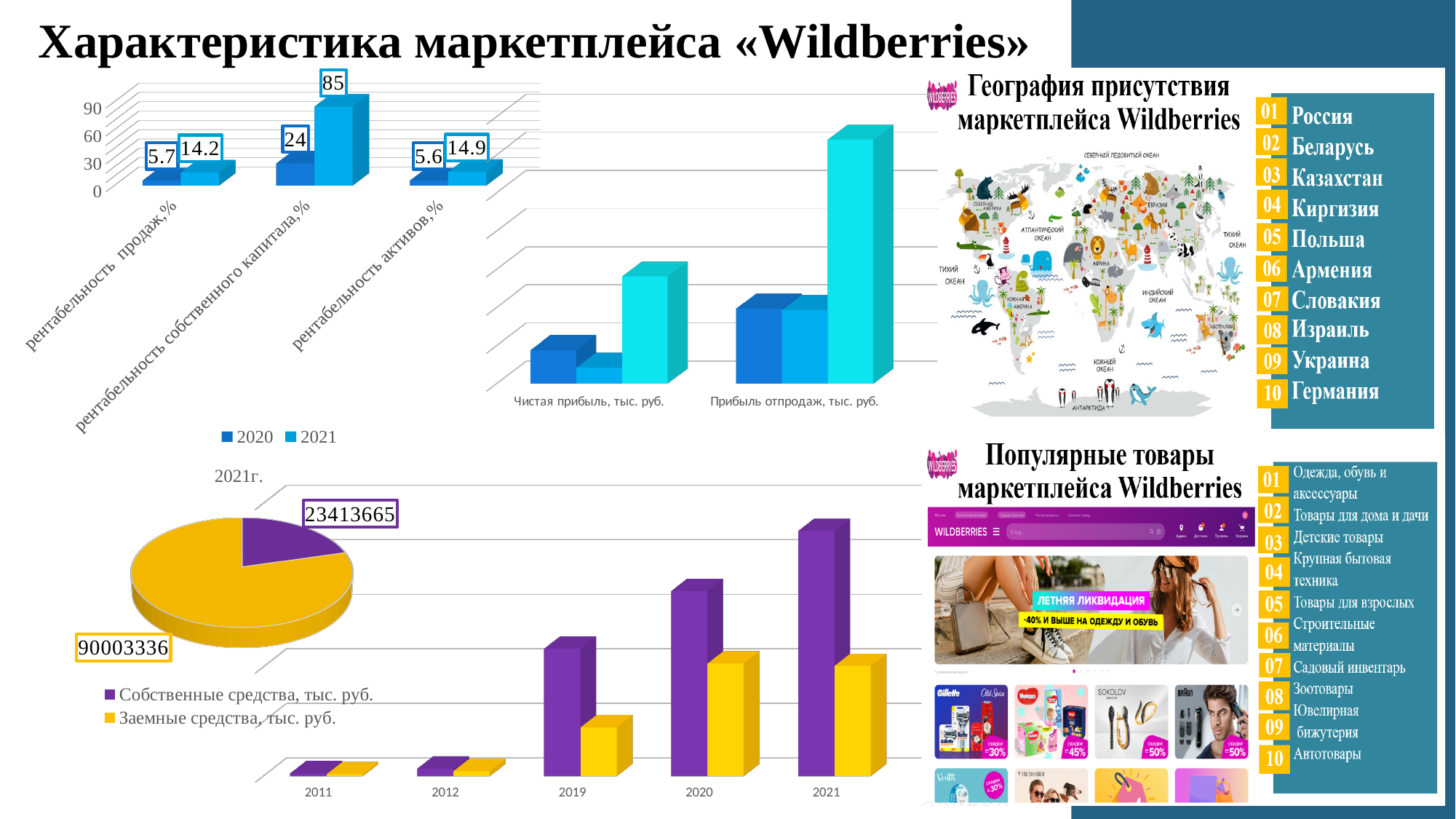
In the top-left bar chart, which is larger: the 2021 value for рентабельность продаж,% or the 2021 value for рентабельность активов,%? рентабельность активов,% In the top-left bar chart, what is the difference between the 2021 and 2020 values for рентабельность собственного капитала,%? 61 In the top-left bar chart, what is the 2020 value for рентабельность продаж,%? 5.7 What kind of chart is the chart labelled 2021г. in the bottom-left of the slide? pie chart In the top-left bar chart, what is the 2021 value for рентабельность активов,%? 14.9 How many years are shown on the x axis of the bottom-middle bar chart? 5 In the top-left bar chart, what is the 2021 value for рентабельность собственного капитала,%? 85 In the pie chart labelled 2021г., what is the value for Собственные средства, тыс. руб.? 23413665 In the pie chart labelled 2021г., which slice is larger: Собственные средства or Заемные средства? Заемные средства, тыс. руб. In the top-left bar chart, which category has the highest 2021 value? рентабельность собственного капитала,% In the pie chart labelled 2021г., what is the value for Заемные средства, тыс. руб.? 90003336 How many series does the legend of the top-left bar chart list? 2